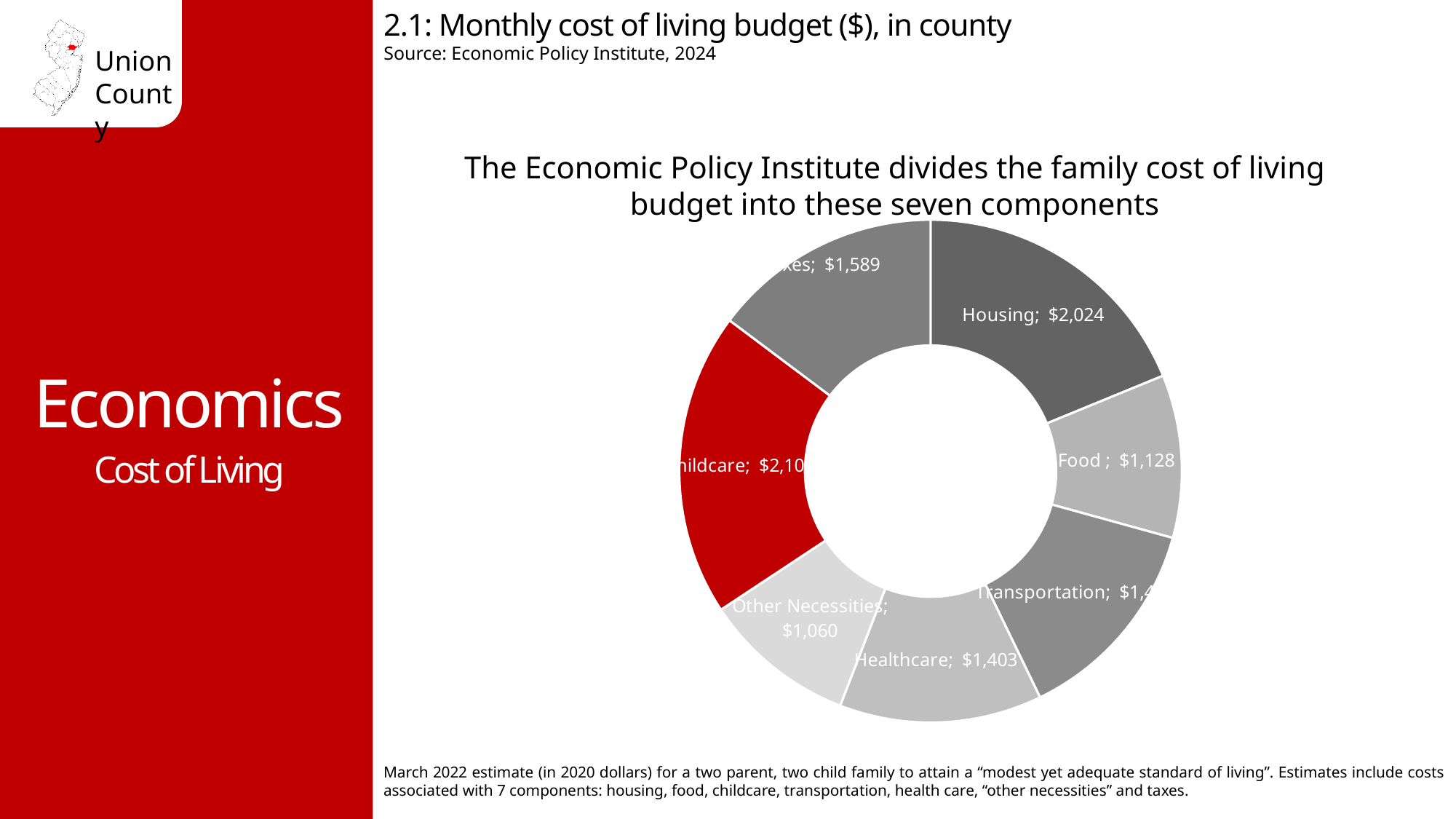
What is the monthly cost for Food in the chart? $1,128 Which is larger, the Food cost or the Healthcare cost? Healthcare What is the monthly cost for Housing in the chart? $2,024 What is the monthly cost for Healthcare in the chart? $1,403 How many components does the chart divide the cost of living budget into? 7 What is the difference between the Housing cost and the Healthcare cost? $621 What is the monthly cost for Other Necessities in the chart? $1,060 What is the difference between the Taxes cost and the Healthcare cost? $186 What is the monthly cost for Taxes in the chart? $1,589 What is the title of the chart on the slide? 2.1: Monthly cost of living budget ($), in county Which is larger, the Housing cost or the Taxes cost? Housing What kind of chart is shown on the slide? Pie (doughnut) chart